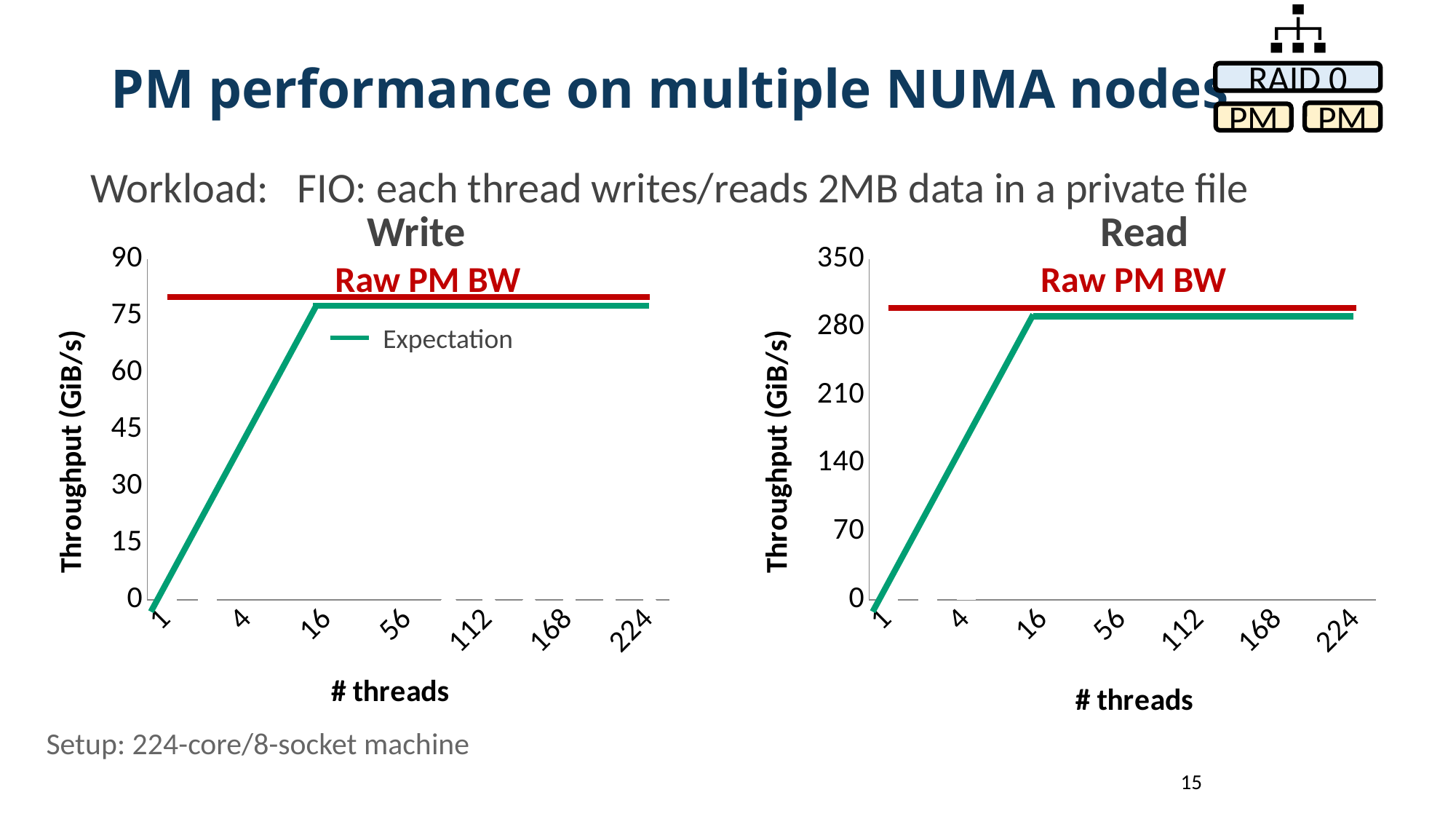
In the Write chart, does the Expectation line rise or fall from 1 thread to 16 threads? rise In the Write chart, which has the larger Expectation value: 4 threads or 16 threads? 16 threads In the Read chart, how does the Expectation line change from 16 threads to 224 threads? It stays flat What is the y-axis label of the Read chart? Throughput (GiB/s) In the Read chart, is the Expectation value at 1 thread greater or less than 70? less In the Write chart, is the Expectation value at 224 threads greater or less than 60? greater How many thread counts are labelled on the x axis of the Read chart? 7 In the Read chart, is the Expectation value at 224 threads greater or less than 210? greater What series name appears in the legend of the Write chart? Expectation What kind of chart is the Write chart? line chart